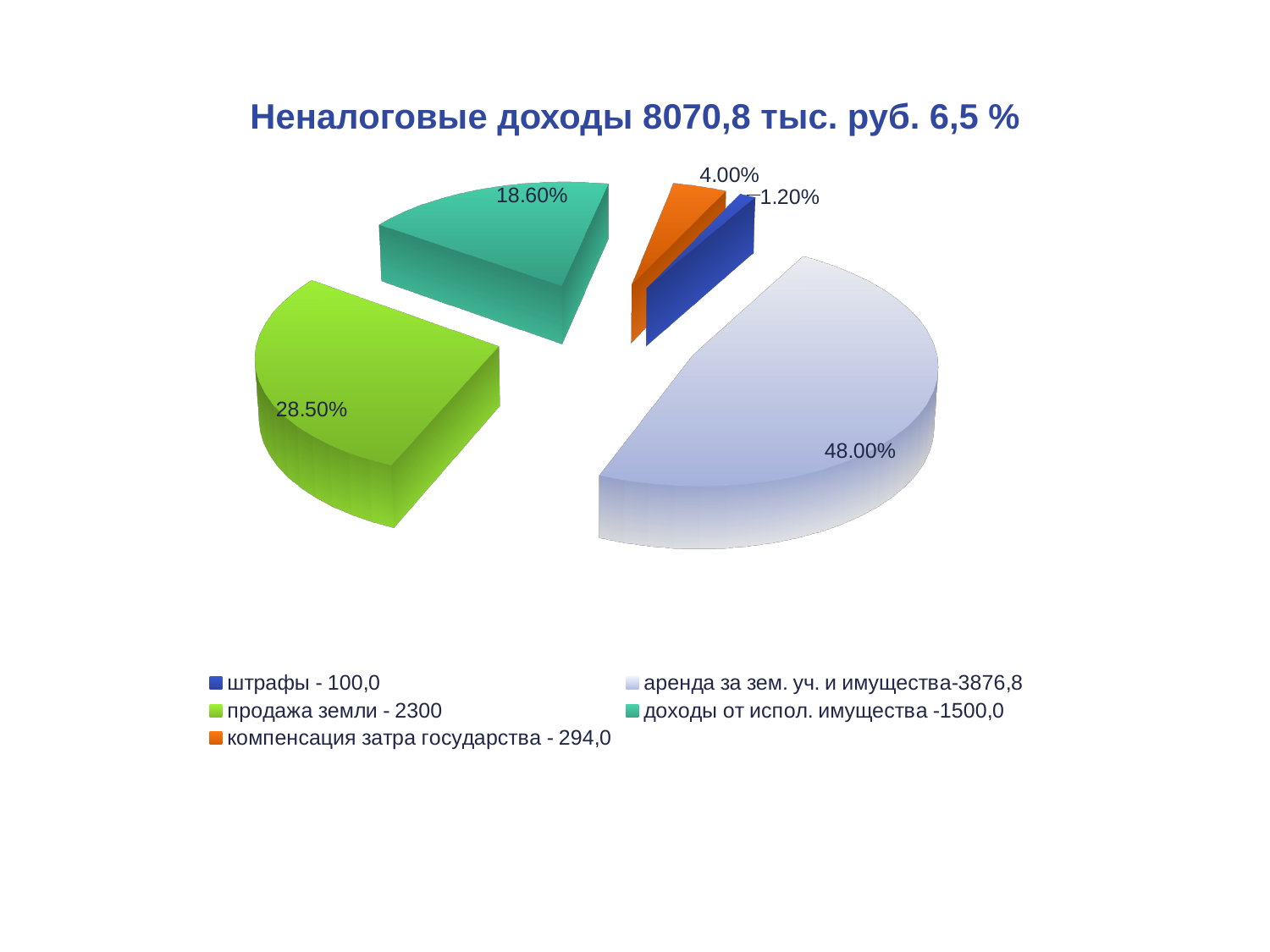
What kind of chart is shown on the slide? Pie chart Which slice has the largest share of the pie? аренда за зем. уч. и имущества-3876,8 What share of the pie does the slice 'продажа земли - 2300' represent? 28.50% Which slice is larger: 'доходы от испол. имущества -1500,0' or 'компенсация затра государства - 294,0'? доходы от испол. имущества -1500,0 What is the difference in percentage points between the 'аренда за зем. уч. и имущества-3876,8' slice and the 'продажа земли - 2300' slice? 19.50% What share of the pie does the slice 'компенсация затра государства - 294,0' represent? 4.00% What is the title of the chart? Неналоговые доходы 8070,8 тыс. руб. 6,5 % How many slices does the pie chart have? 5 What share of the pie does the slice 'доходы от испол. имущества -1500,0' represent? 18.60% Which slice has the smallest share of the pie? штрафы - 100,0